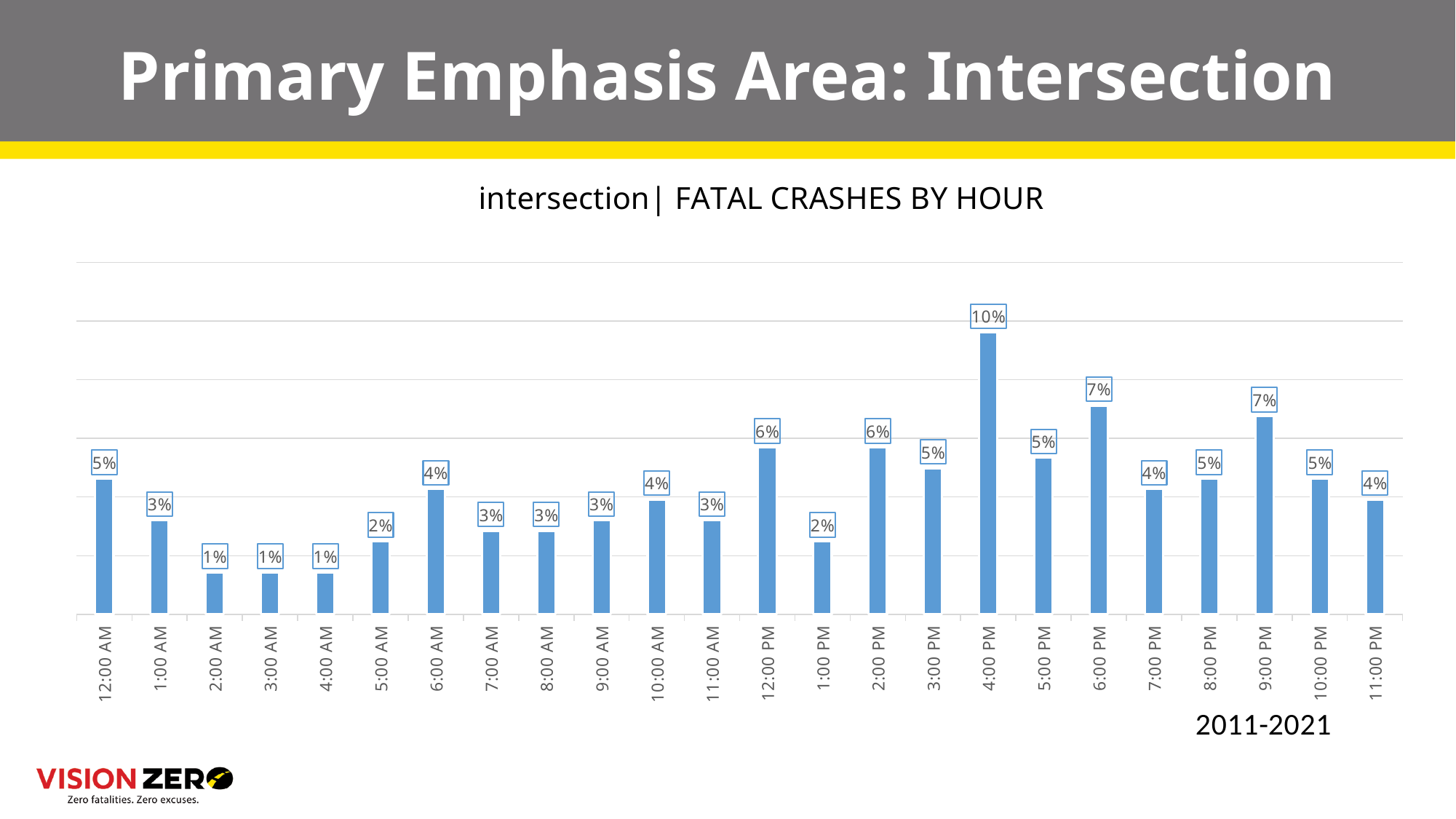
What is the difference between the values for 4:00 PM and 6:00 PM? 3% What kind of chart is shown on the slide? Bar chart What year range is noted below the chart? 2011-2021 What is the difference between the values for 12:00 PM and 1:00 PM? 4% What is the title of the chart? intersection| FATAL CRASHES BY HOUR Which hour has the highest share of fatal crashes? 4:00 PM What percentage is shown for 1:00 PM? 2% Do the values rise or fall from 12:00 AM to 2:00 AM? Fall What percentage of fatal crashes at intersections occurred at 4:00 PM? 10% How many hour categories are plotted on the x axis? 24 What is the value shown for 12:00 AM? 5% Which is larger, the value for 9:00 PM or the value for 11:00 PM? 9:00 PM